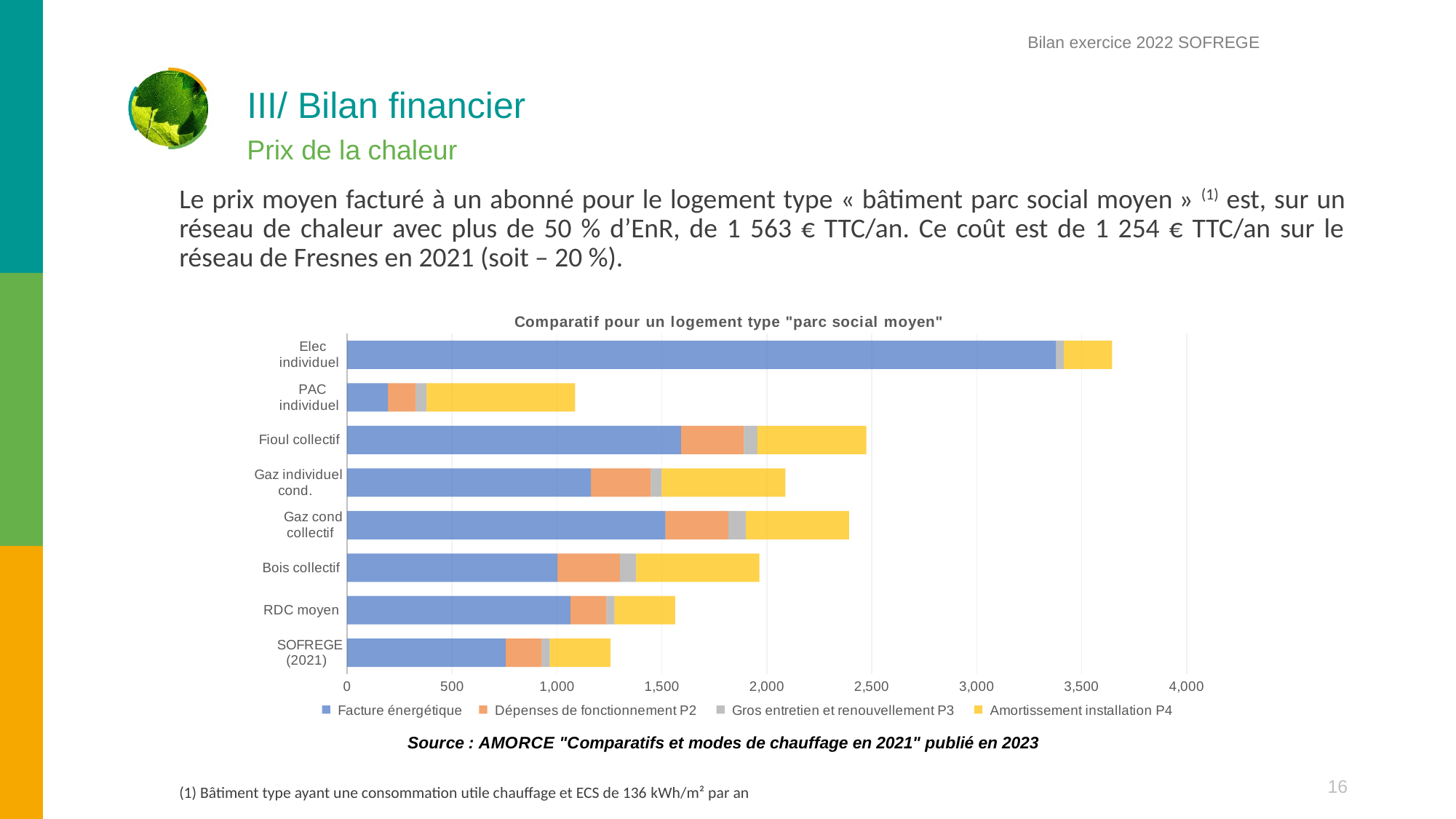
Which has a larger total cost, Fioul collectif or Gaz individuel cond.? Fioul collectif Which category has the lowest total cost on the chart? PAC individuel Is the 'Facture énergétique' value for Elec individuel greater or less than 3,000? greater What kind of chart is shown on the slide? Stacked bar chart Which category has the highest total cost on the chart? Elec individuel Is the total for Fioul collectif greater or less than 2,000? greater How many categories (heating modes) are shown on the chart? 8 What is the title of the chart? Comparatif pour un logement type "parc social moyen" Is the total for Elec individuel greater or less than 3,500? greater Which category has the smallest 'Facture énergétique' segment? PAC individuel How many series does the chart legend list? 4